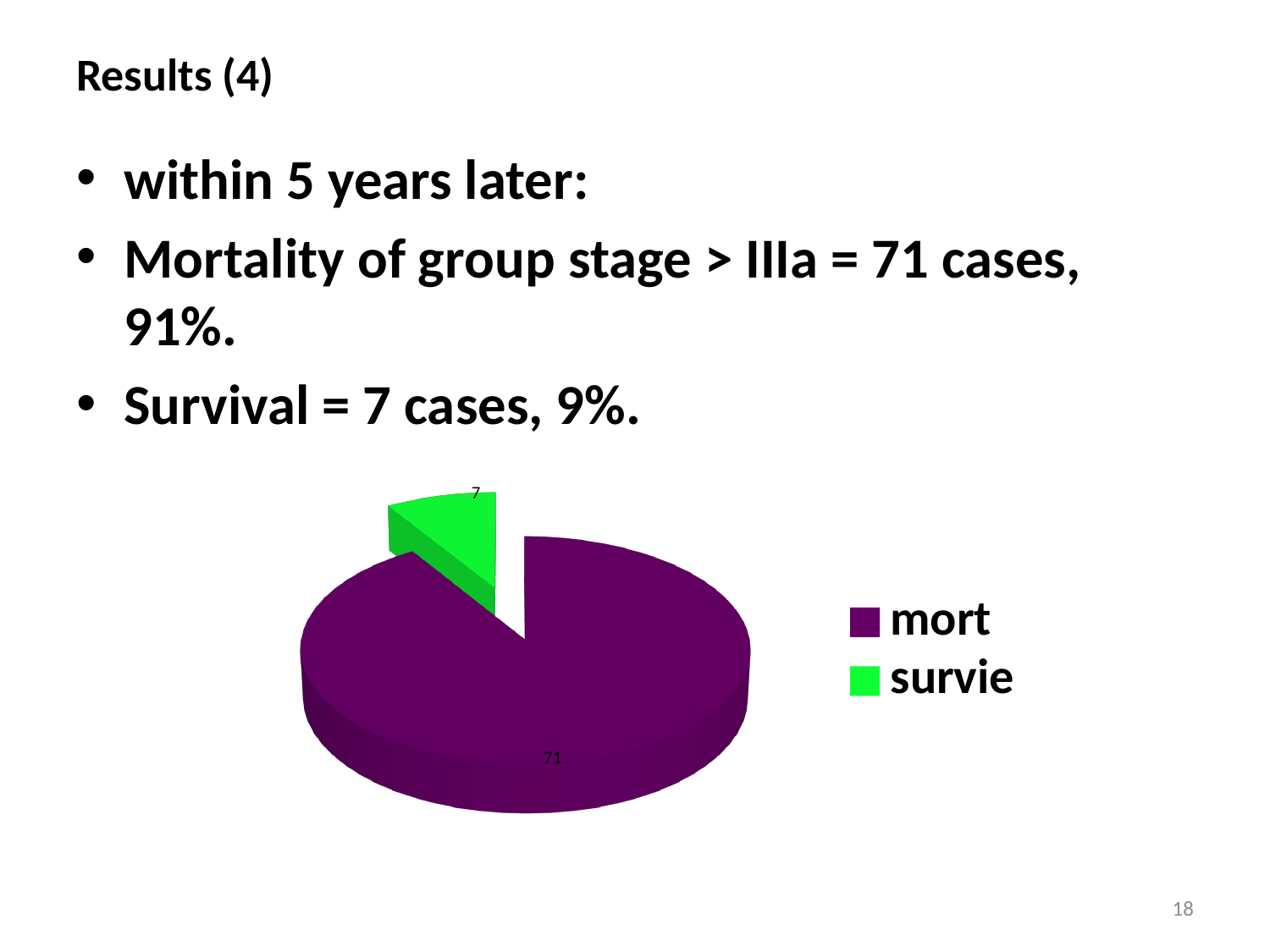
What is the value for the 'survie' slice? 7 How many slices does the pie chart have? 2 Which slice is the largest? mort What is the total of all slices in the pie chart? 78 What is the value for the 'mort' slice? 71 Which slice is the smallest? survie How many entries does the legend list? 2 What colour is the 'mort' slice? purple Which is larger, 'mort' or 'survie'? mort What kind of chart is shown on the slide? pie chart What is the difference between the 'mort' and 'survie' values? 64 What colour is the 'survie' slice? green